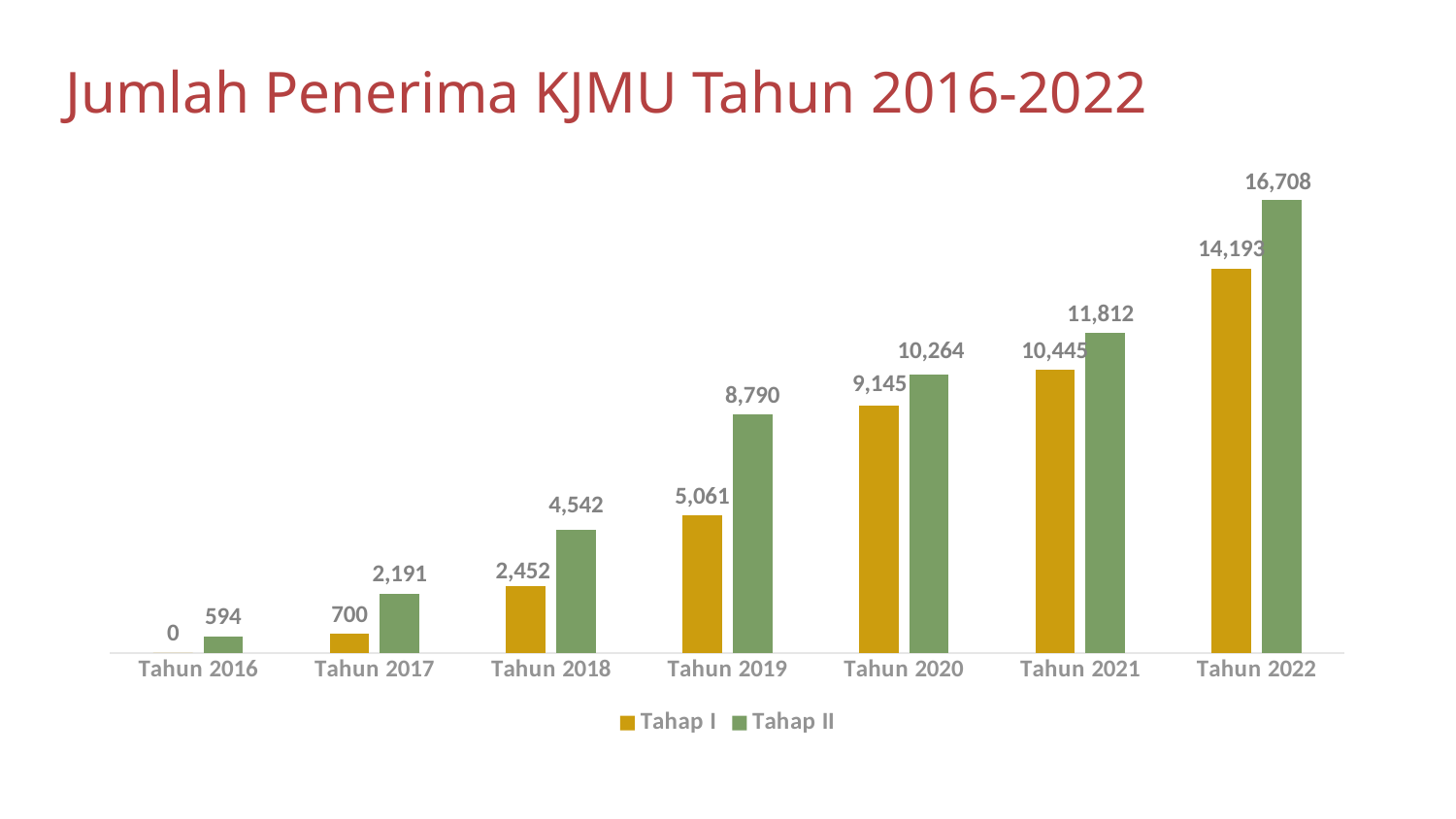
Which year has the lowest Tahap II value? Tahun 2016 What kind of chart is shown on the slide? Bar chart What is the Tahap I value for Tahun 2019? 5,061 Which year has the highest Tahap II value? Tahun 2022 How many series does the legend list? 2 Do the Tahap II values rise or fall from Tahun 2016 to Tahun 2022? Rise What is the difference between Tahap II and Tahap I for Tahun 2021? 1,367 What is the Tahap I value for Tahun 2016? 0 How many years are shown on the x axis? 7 Which is larger for Tahun 2018: Tahap I or Tahap II? Tahap II What is the title of the chart? Jumlah Penerima KJMU Tahun 2016-2022 What is the Tahap II value for Tahun 2022? 16,708